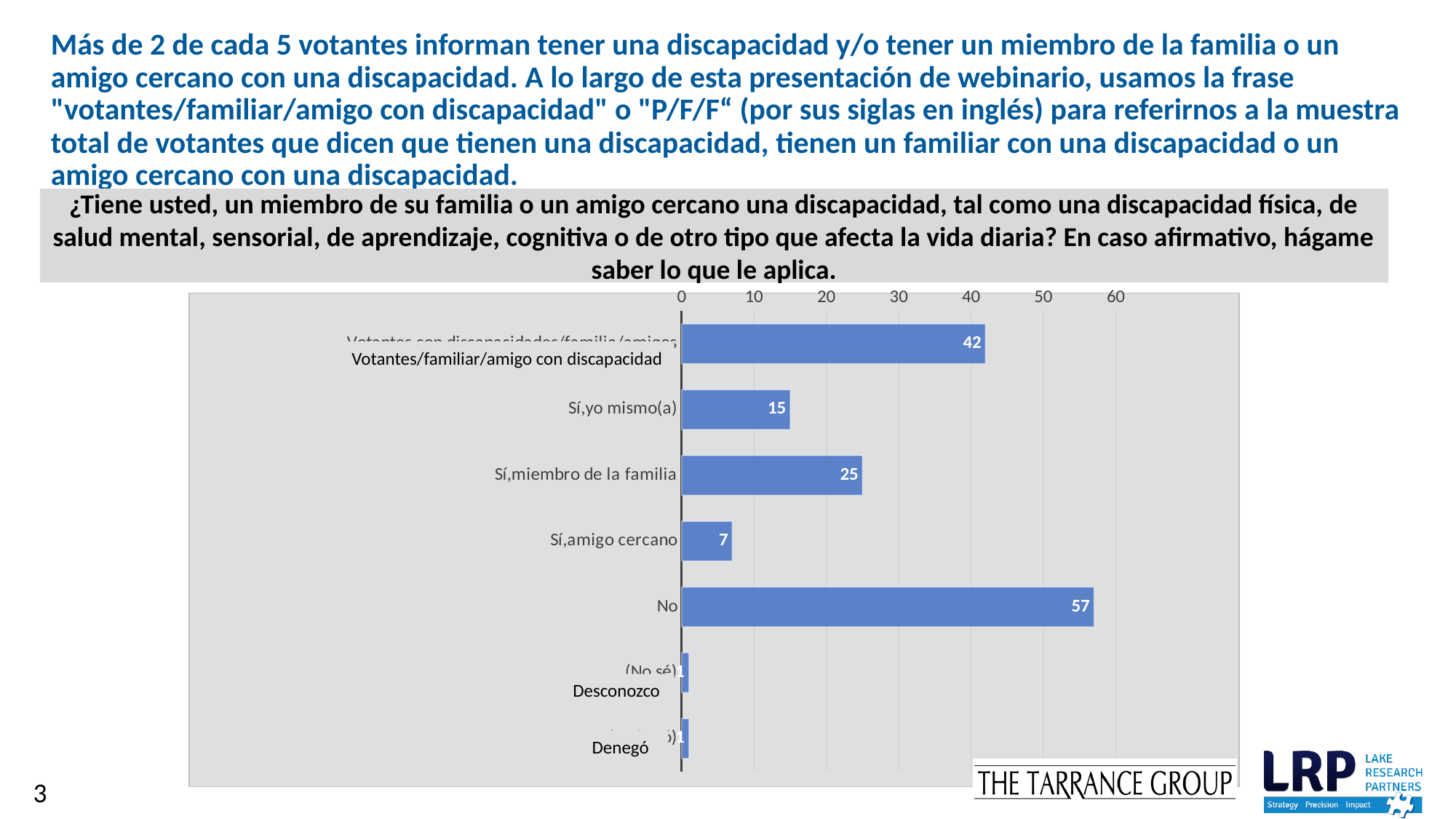
What is the difference between the values for "No" and "Votantes/familiar/amigo con discapacidad"? 15 How many categories are shown in the chart? 7 What is the value for "No"? 57 Which is larger, the value for "Sí,miembro de la familia" or the value for "Sí,amigo cercano"? Sí,miembro de la familia What is the difference between the values for "Sí,miembro de la familia" and "Sí,yo mismo(a)"? 10 What type of chart is shown on the slide? Bar chart Which category has the highest value? No Is the value for "Sí,amigo cercano" greater or less than 10? less What is the value for "Sí,amigo cercano"? 7 What is the value for "Sí,yo mismo(a)"? 15 What is the value for "Sí,miembro de la familia"? 25 What is the value for "Votantes/familiar/amigo con discapacidad"? 42